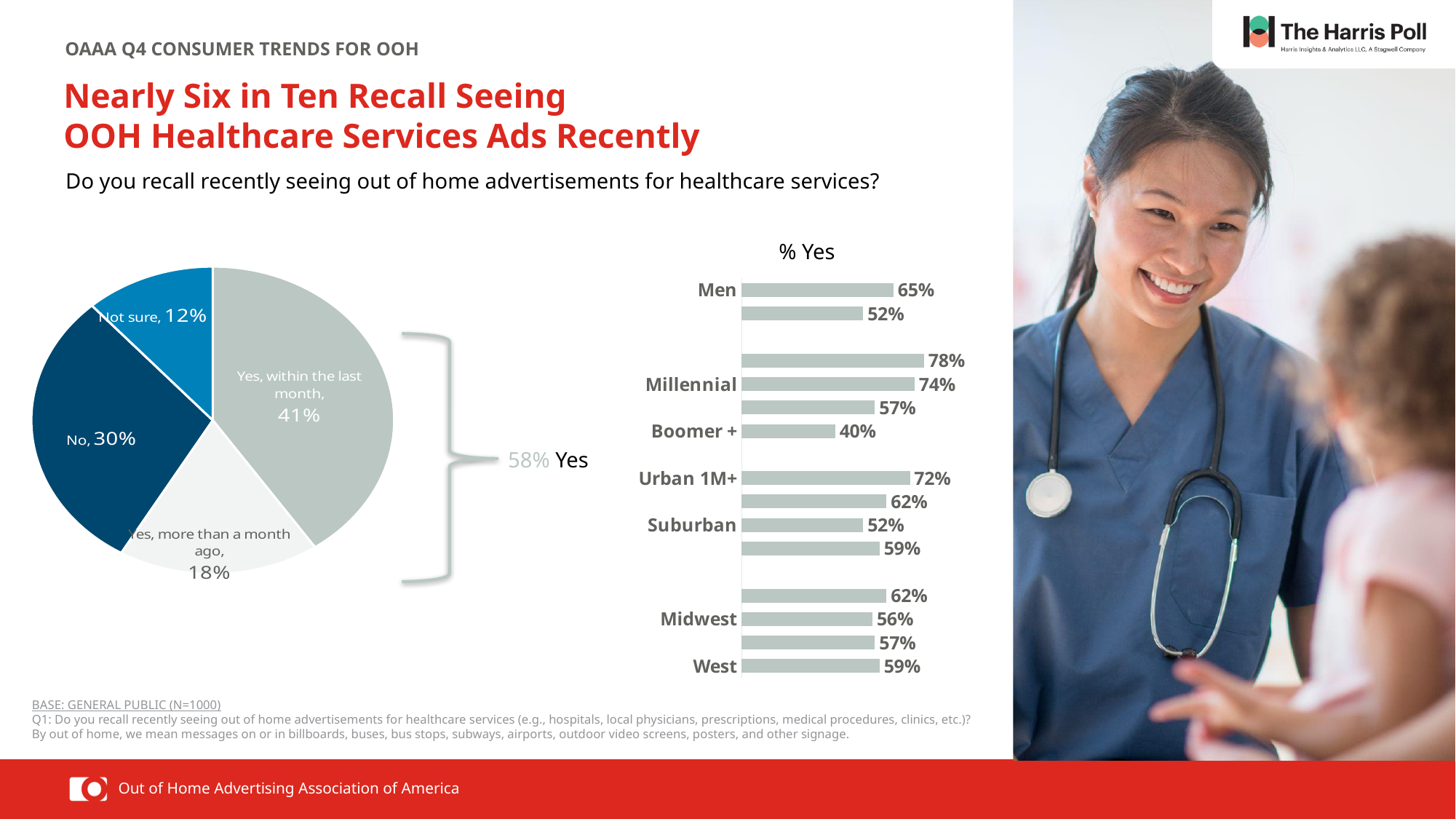
In the pie chart, which response has the smallest slice? Not sure In the pie chart, what share of respondents said 'No'? 30% In the pie chart, which response has the largest slice? Yes, within the last month What kind of chart is the '% Yes' chart on the right? Bar chart In the pie chart, what share of respondents said 'Yes, within the last month'? 41% In the '% Yes' bar chart, which is larger, Midwest or West? West In the pie chart, what share of respondents said 'Not sure'? 12% In the '% Yes' bar chart, what is the value for Men? 65% In the '% Yes' bar chart, what is the value for Boomer +? 40% In the '% Yes' bar chart, what is the difference between Urban 1M+ and Suburban? 20% In the pie chart, what is the combined share of the two 'Yes' slices? 58% In the pie chart, how many slices are there? 4